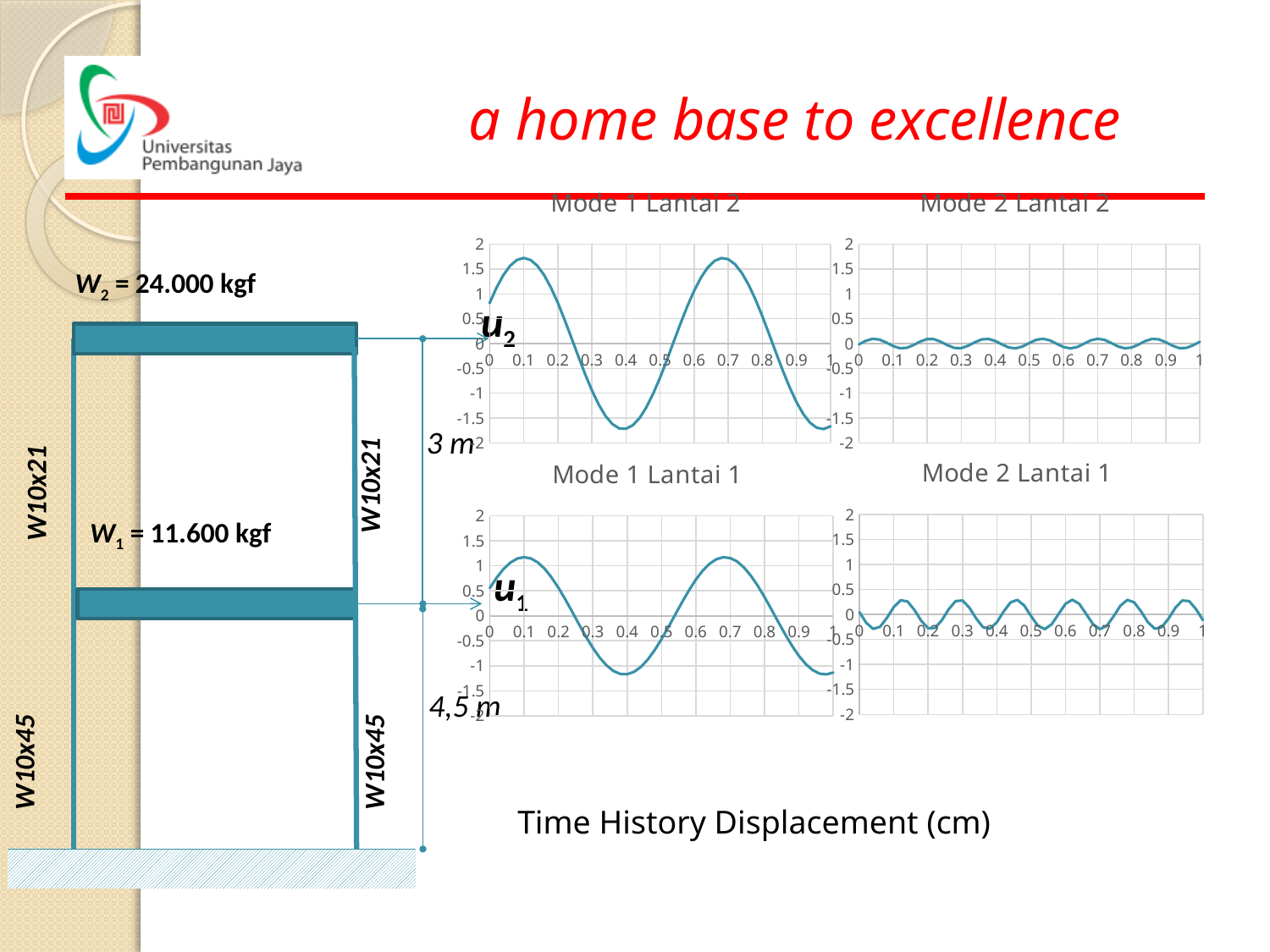
Which chart reaches a higher peak value, "Mode 1 Lantai 2" or "Mode 1 Lantai 1"? Mode 1 Lantai 2 In the "Mode 2 Lantai 2" chart, is the largest value reached greater or less than 0.5? less What kind of chart is the "Mode 1 Lantai 2" chart? line chart What is the title of the chart in the top-right position? Mode 2 Lantai 2 How many charts are shown on the slide? 4 Which chart shows larger oscillations, "Mode 2 Lantai 1" or "Mode 2 Lantai 2"? Mode 2 Lantai 1 In the "Mode 1 Lantai 2" chart, is the minimum value at about 0.4 greater or less than -1.5? less In the "Mode 2 Lantai 1" chart, is the largest value reached greater or less than 0.5? less What is the maximum value shown on the vertical axis of the "Mode 1 Lantai 1" chart? 2 In the "Mode 1 Lantai 2" chart, does the value rise or fall between x = 0 and x = 0.1? rise